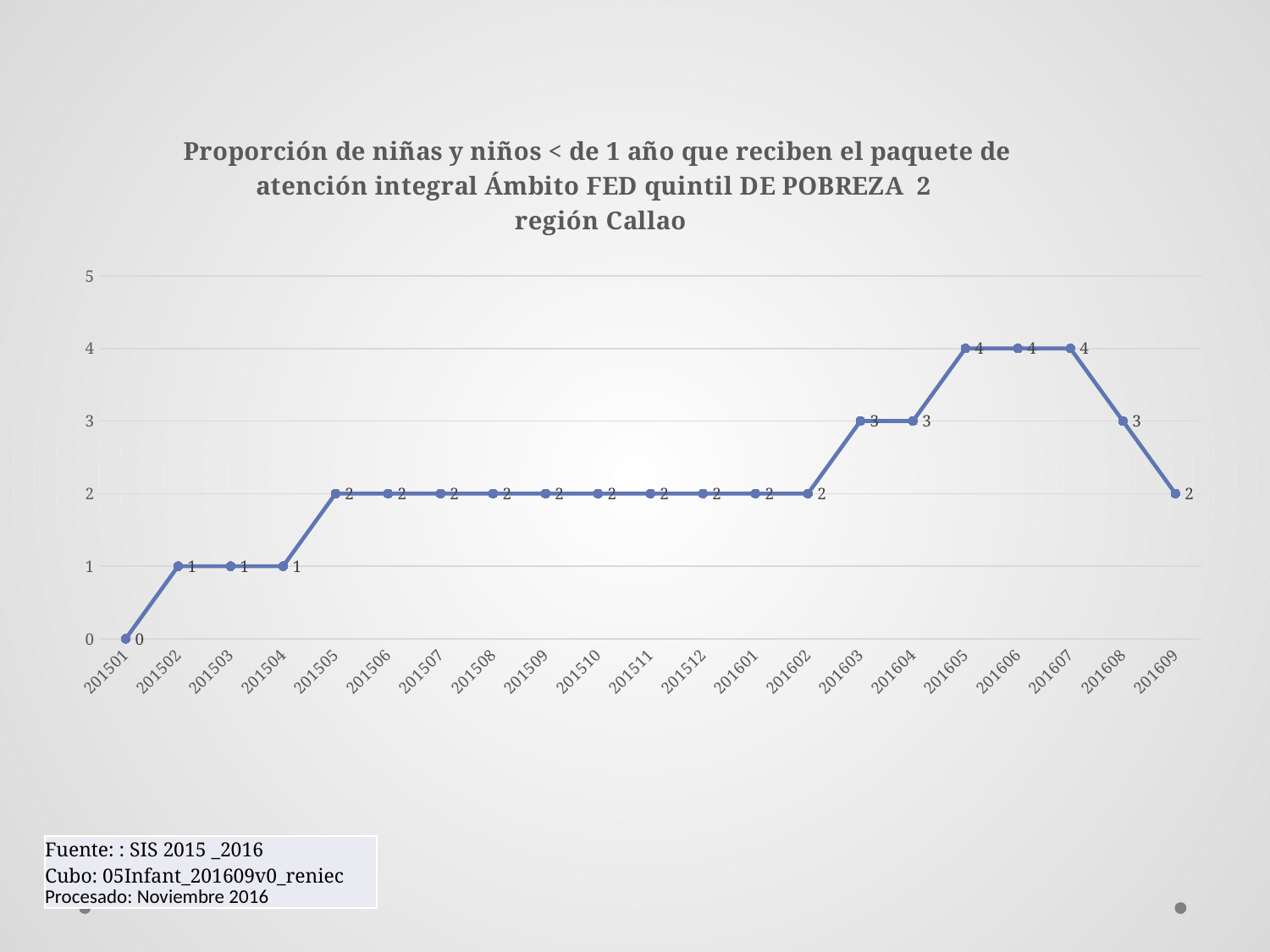
What is the value for 201501? 0 Which is larger, the value for 201604 or the value for 201608? They are equal (3) What is the value for 201603? 3 What type of chart is shown on the slide? line chart What is the value for 201605? 4 Which period has the lowest value? 201501 How many data points are plotted on the chart? 21 What is the difference between the values for 201607 and 201609? 2 What is the value for 201609? 2 What is the highest value reached on the chart? 4 Does the value rise or fall from 201607 to 201609? fall Which region does the chart title refer to? Callao